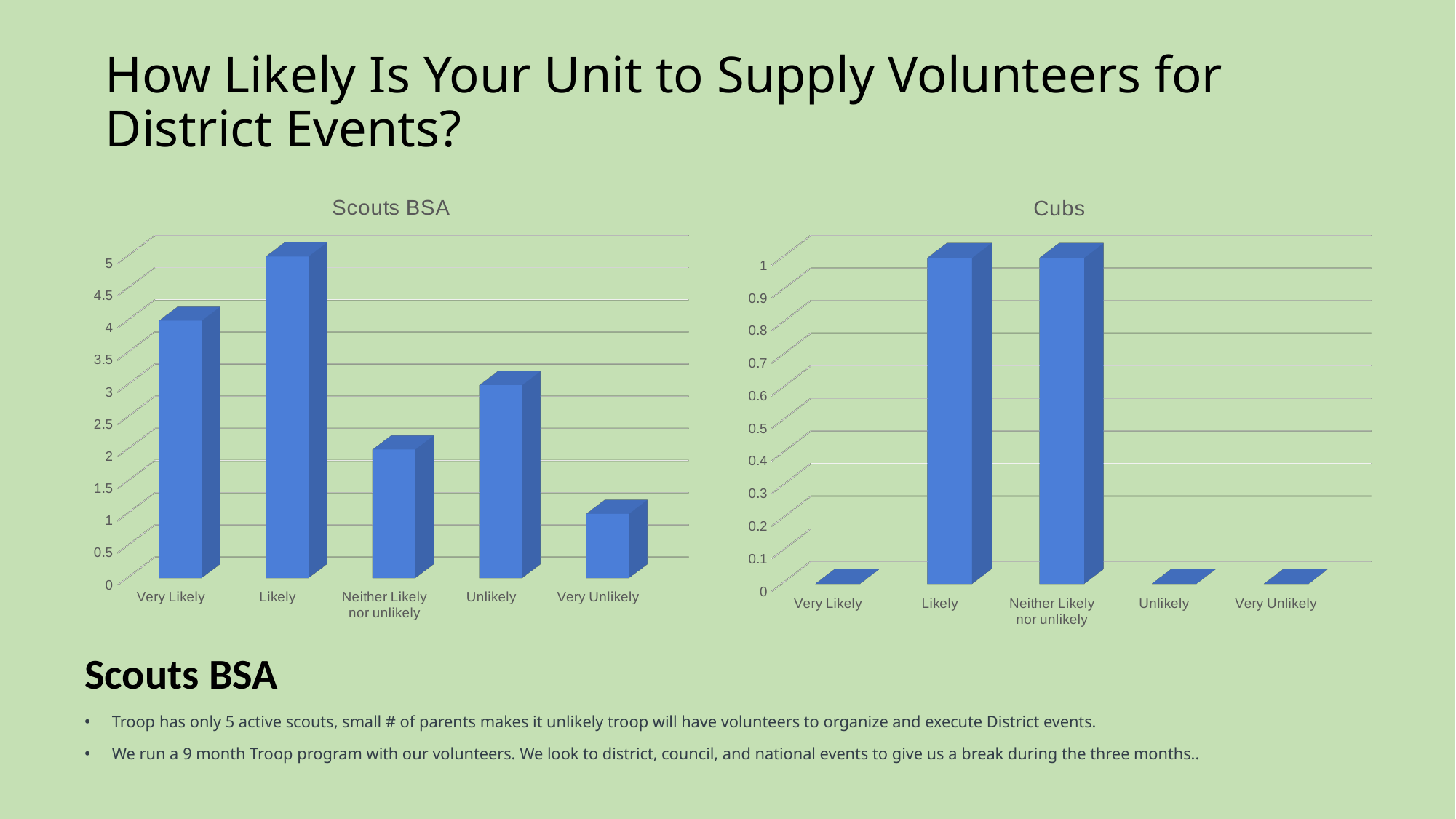
In the Scouts BSA chart, which category has the lowest value? Very Unlikely In the Cubs chart, what is the value for Likely? 1 In the Cubs chart, what is the value for Very Likely? 0 In the Scouts BSA chart, what is the value for Unlikely? 3 What is the title of the chart on the right side of the slide? Cubs In the Scouts BSA chart, is the value for Neither Likely nor unlikely greater or less than 3? less How many categories are shown in the Scouts BSA chart? 5 In the Scouts BSA chart, what is the value for Very Likely? 4 In the Scouts BSA chart, which category has the highest value? Likely In the Scouts BSA chart, what is the value for Likely? 5 What kind of chart is the Scouts BSA chart? bar chart In the Scouts BSA chart, which is larger, Very Likely or Unlikely? Very Likely